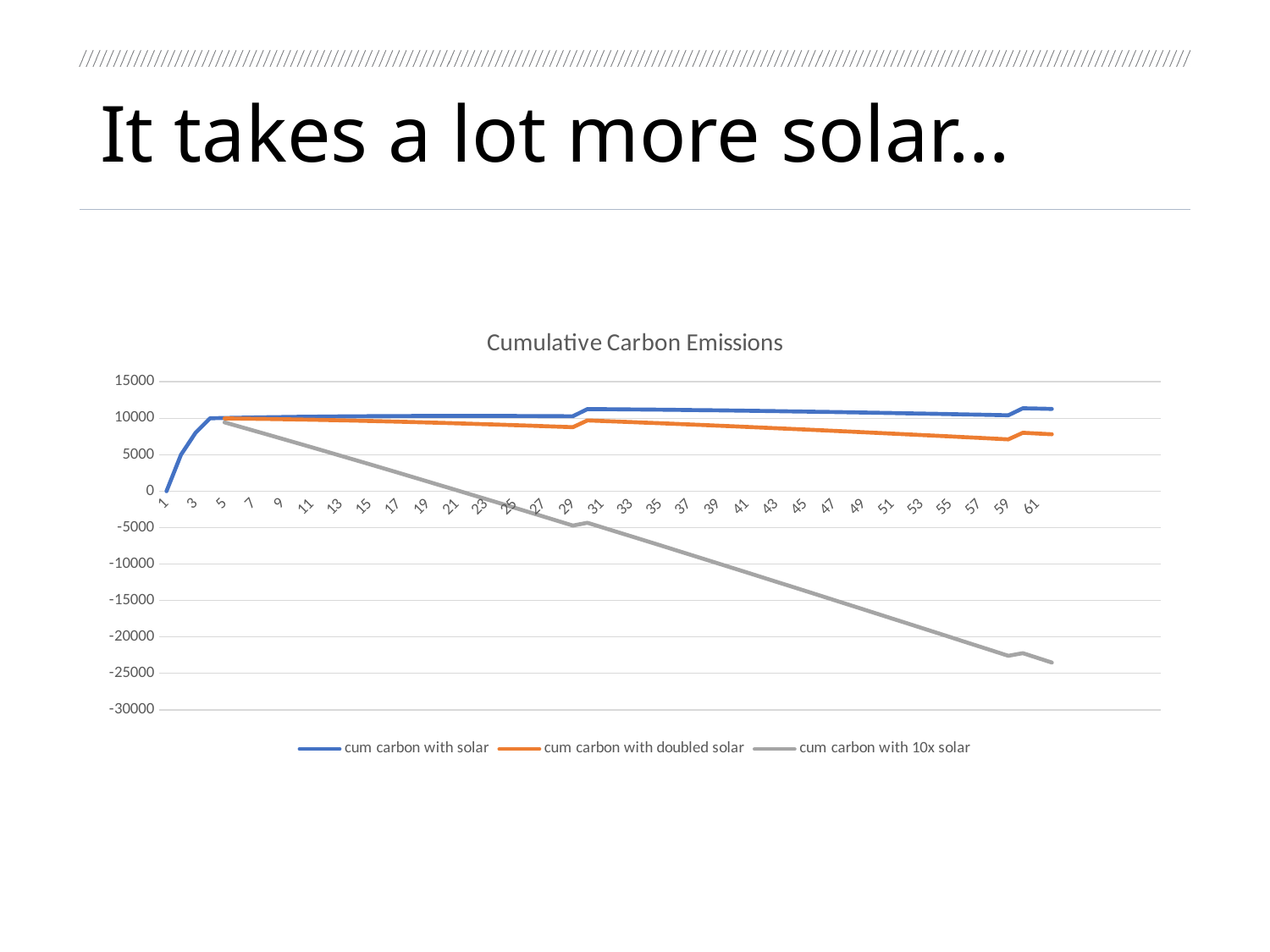
Is the value of cum carbon with 10x solar at x = 61 greater or less than -20000? less Is the value of cum carbon with doubled solar at x = 61 greater or less than 10000? less Is the value of cum carbon with solar at x = 61 greater or less than 10000? greater What is the title of the chart on the slide? Cumulative Carbon Emissions How many series does the legend of the Cumulative Carbon Emissions chart list? 3 What kind of chart is shown on the slide? line chart Which series in the Cumulative Carbon Emissions chart is drawn in gray? cum carbon with 10x solar Which series has the lowest value at the right end of the chart? cum carbon with 10x solar At x = 61, which series is higher: cum carbon with solar or cum carbon with doubled solar? cum carbon with solar After its initial rise, does the cum carbon with doubled solar series rise or fall along the x axis? fall Does the cum carbon with 10x solar series rise or fall along the x axis after its starting point? fall